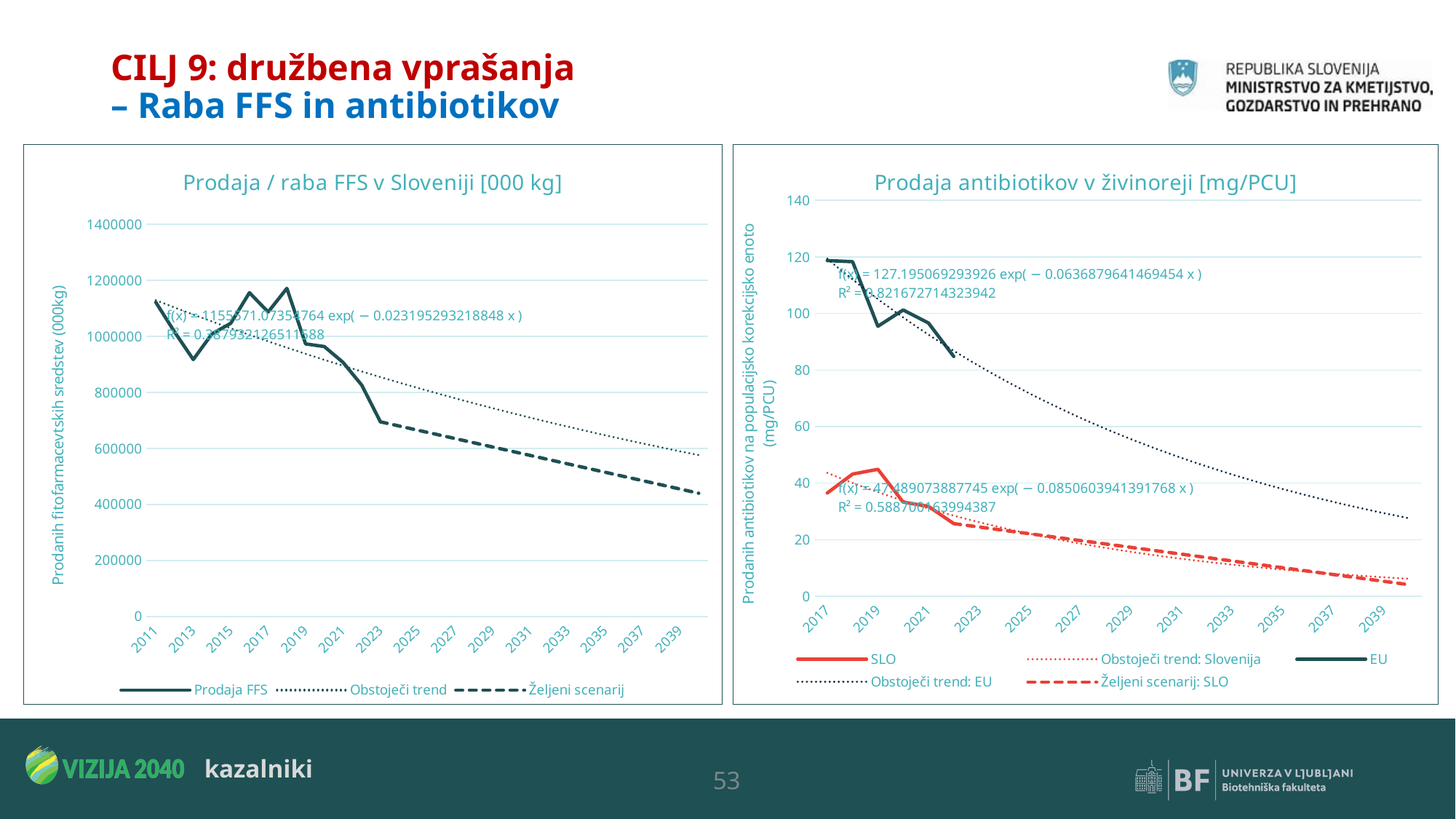
What is the title of the right chart? Prodaja antibiotikov v živinoreji [mg/PCU] How many series does the legend of the left chart 'Prodaja / raba FFS v Sloveniji' list? 3 In the right chart 'Prodaja antibiotikov v živinoreji', is the SLO value for 2019 greater or less than 40? greater In the right chart 'Prodaja antibiotikov v živinoreji', which series has the larger value in 2017, EU or SLO? EU What kind of chart is the left chart, 'Prodaja / raba FFS v Sloveniji [000 kg]'? line chart What kind of chart is the right chart, 'Prodaja antibiotikov v živinoreji [mg/PCU]'? line chart In the left chart 'Prodaja / raba FFS v Sloveniji', does the Prodaja FFS line overall rise or fall from 2011 to 2023? fall In the left chart 'Prodaja / raba FFS v Sloveniji', is the Prodaja FFS value for 2011 greater or less than 1000000? greater How many series does the legend of the right chart 'Prodaja antibiotikov v živinoreji' list? 5 In the left chart 'Prodaja / raba FFS v Sloveniji', is the Prodaja FFS value for 2023 greater or less than 800000? less